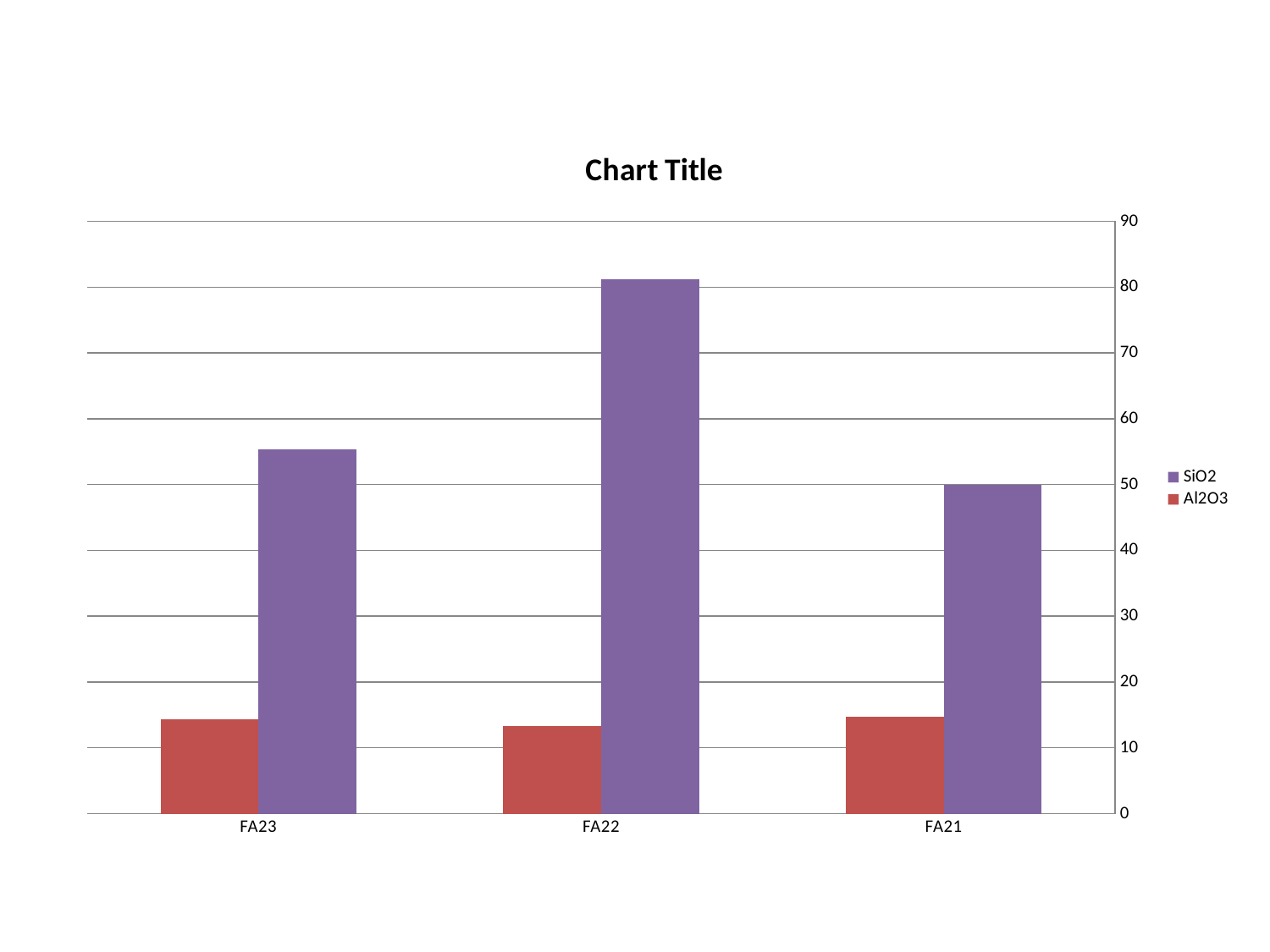
What is the title of the chart? Chart Title Is the Al2O3 value for FA22 greater or less than 20? less Is the SiO2 value for FA22 greater or less than 70? greater Is the Al2O3 value for FA23 greater or less than 10? greater Which is larger for FA22, the SiO2 value or the Al2O3 value? SiO2 Which category has the highest SiO2 value? FA22 How many series does the legend list? 2 How many categories are shown on the x axis? 3 What kind of chart is shown on the slide? bar chart Which category has the lowest SiO2 value? FA21 Which series is shown in purple? SiO2